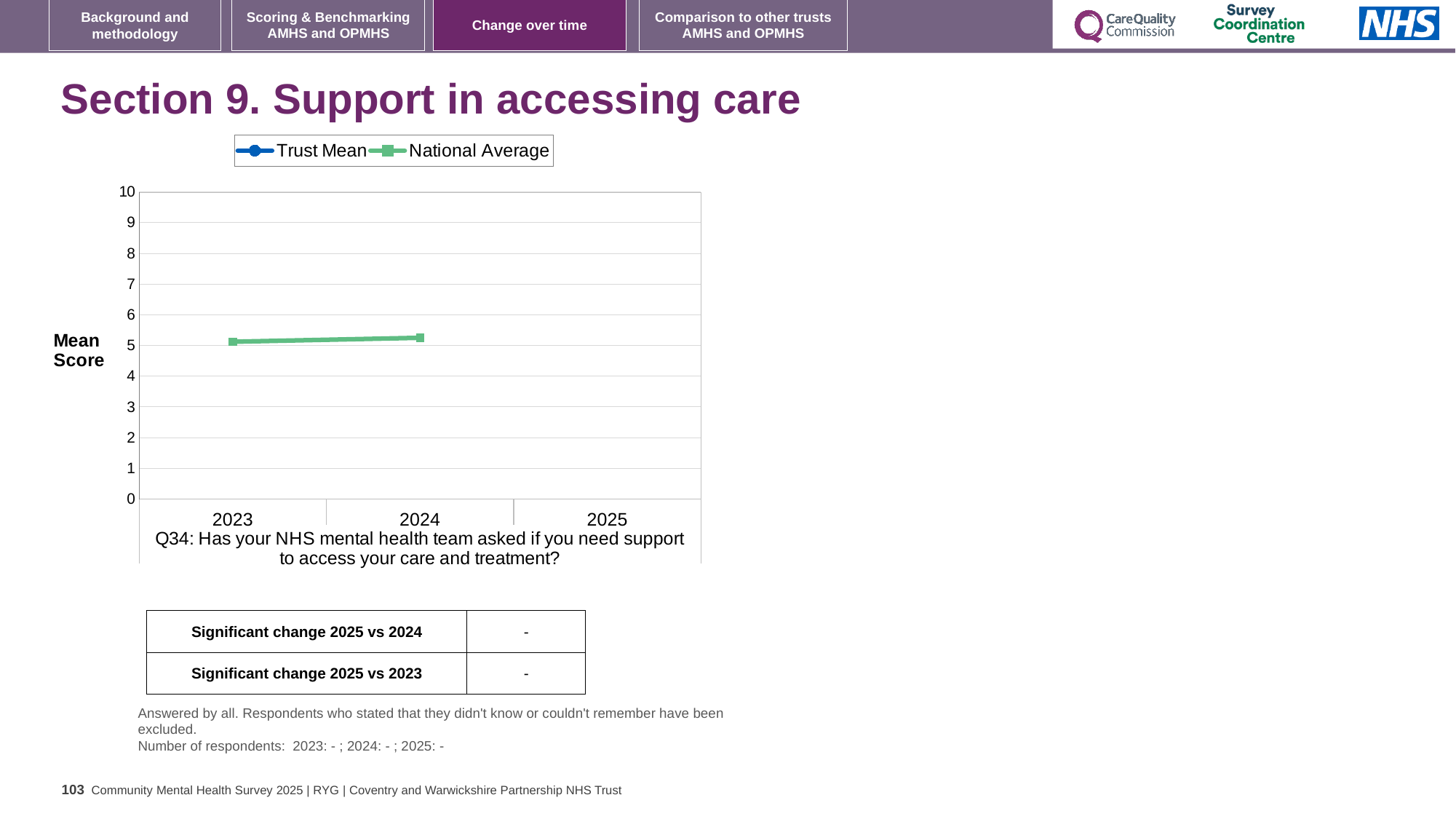
Is the National Average value for 2024 greater or less than 6? less What kind of chart is shown on the slide? line chart How many series does the chart legend list? 2 How many years are shown on the x axis of the chart? 3 Is the National Average value for 2024 greater or less than 4? greater Does the National Average line rise or fall from 2023 to 2024? rise What is the highest value shown on the y axis of the chart? 10 What is the label on the y axis of the chart? Mean Score Which series has a plotted line visible on the chart? National Average Is the National Average value for 2023 greater or less than 6? less